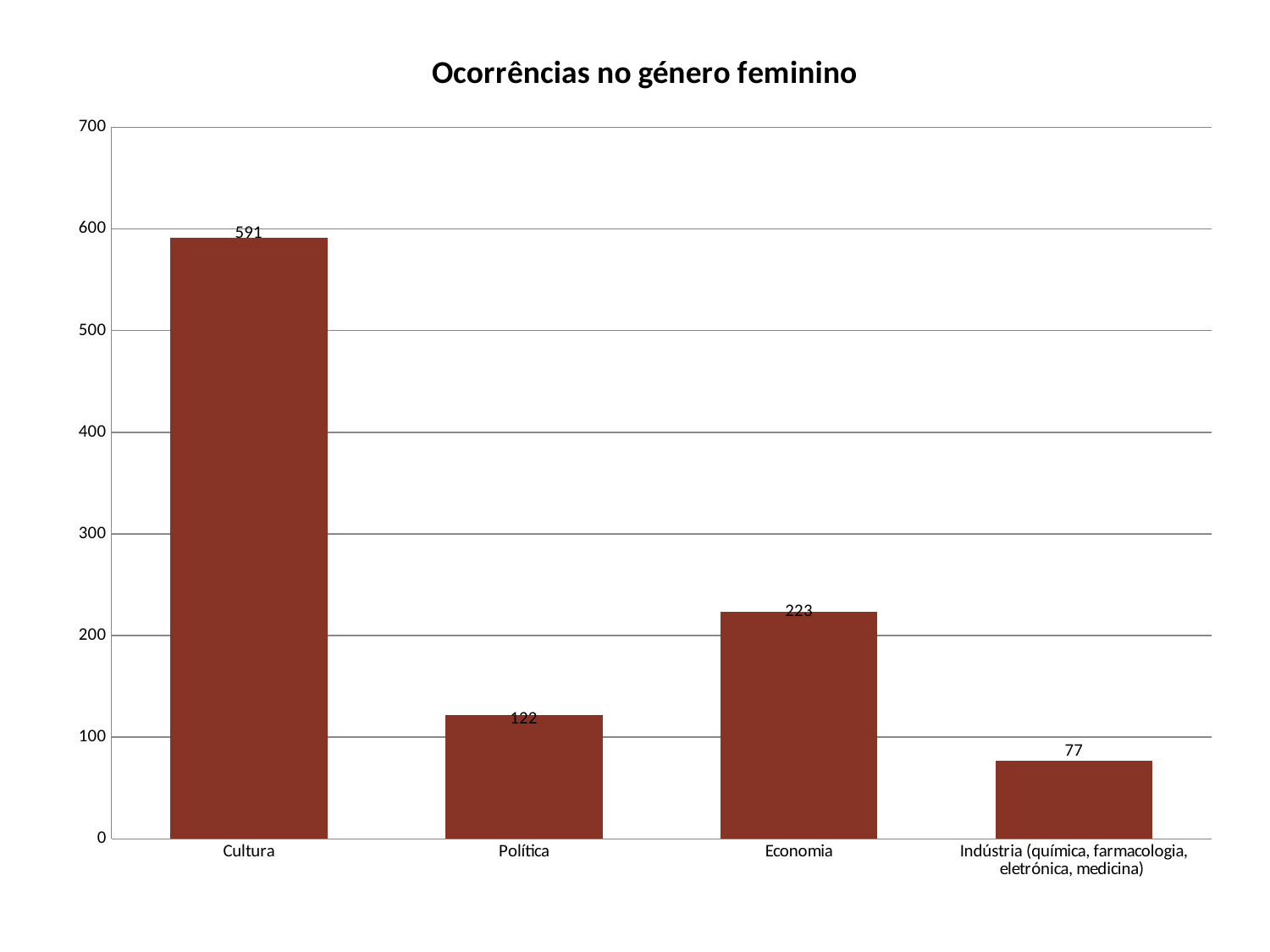
Which category has the lowest value? Indústria (química, farmacologia, eletrónica, medicina) What is the value for Cultura? 591 What is the value for Indústria (química, farmacologia, eletrónica, medicina)? 77 What is the value for Economia? 223 What kind of chart is shown on the slide? Bar chart Which is larger, the value for Política or the value for Economia? Economia How many categories are shown in the chart? 4 Which category has the highest value? Cultura What is the difference between the values for Política and Indústria (química, farmacologia, eletrónica, medicina)? 45 What is the difference between the values for Cultura and Economia? 368 What is the value for Política? 122 Is the value for Economia greater or less than 200? greater